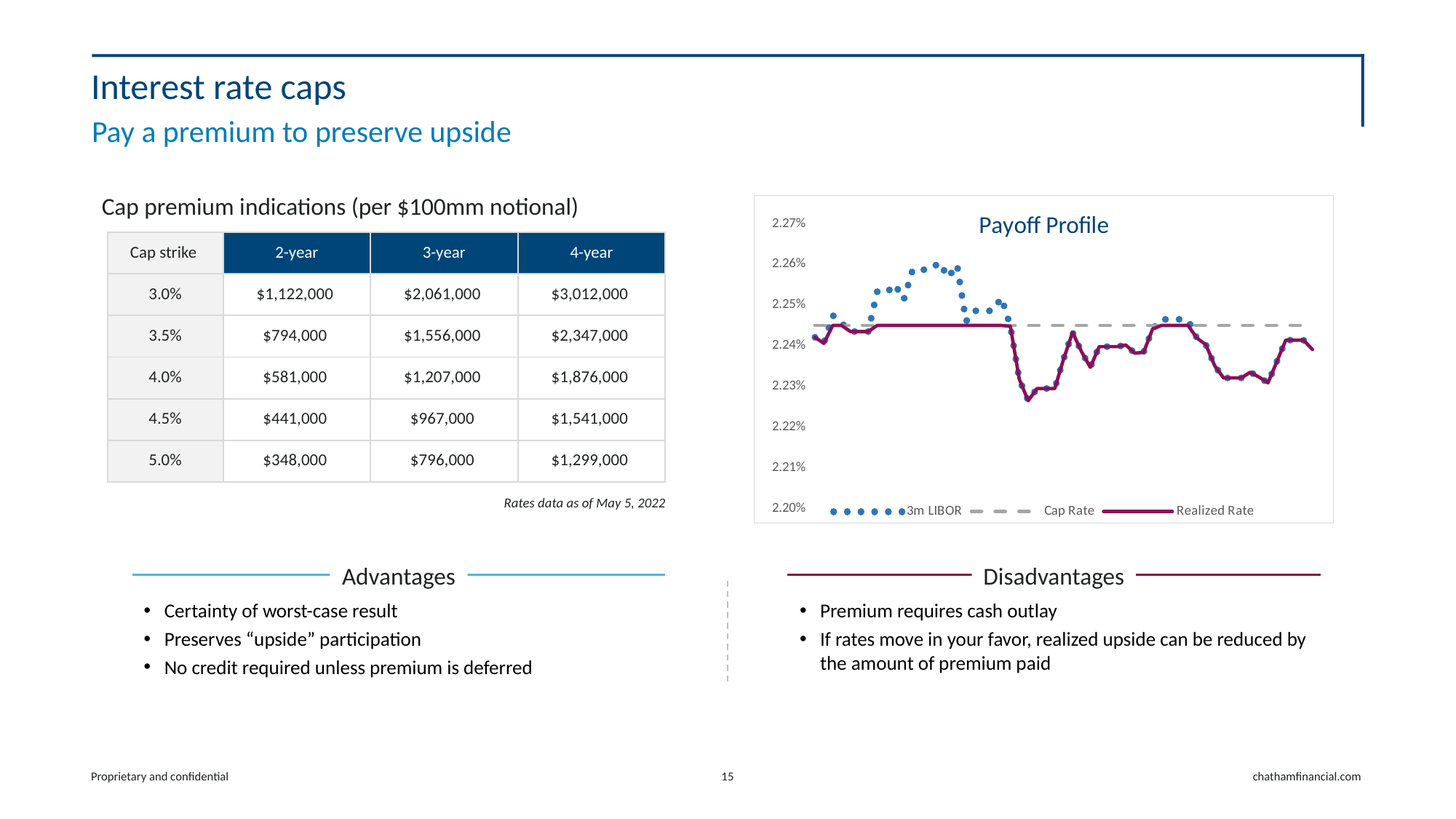
In the Payoff Profile chart, which series is drawn as a dashed line? Cap Rate What kind of chart is the Payoff Profile chart? line chart In the Payoff Profile chart, is the lowest value of the Realized Rate greater or less than 2.24%? less In the Payoff Profile chart, is the Cap Rate greater or less than 2.25%? less In the Payoff Profile chart, which series reaches the highest value shown? 3m LIBOR In the Payoff Profile chart, at its peak, is 3m LIBOR higher or lower than the Cap Rate? higher In the Payoff Profile chart, is the highest value of 3m LIBOR greater or less than 2.25%? greater In the Payoff Profile chart, does the Realized Rate ever rise above the Cap Rate? No How many series does the legend of the Payoff Profile chart list? 3 What is the title of the chart on the slide? Payoff Profile What is the lowest value shown on the y-axis of the Payoff Profile chart? 2.20%